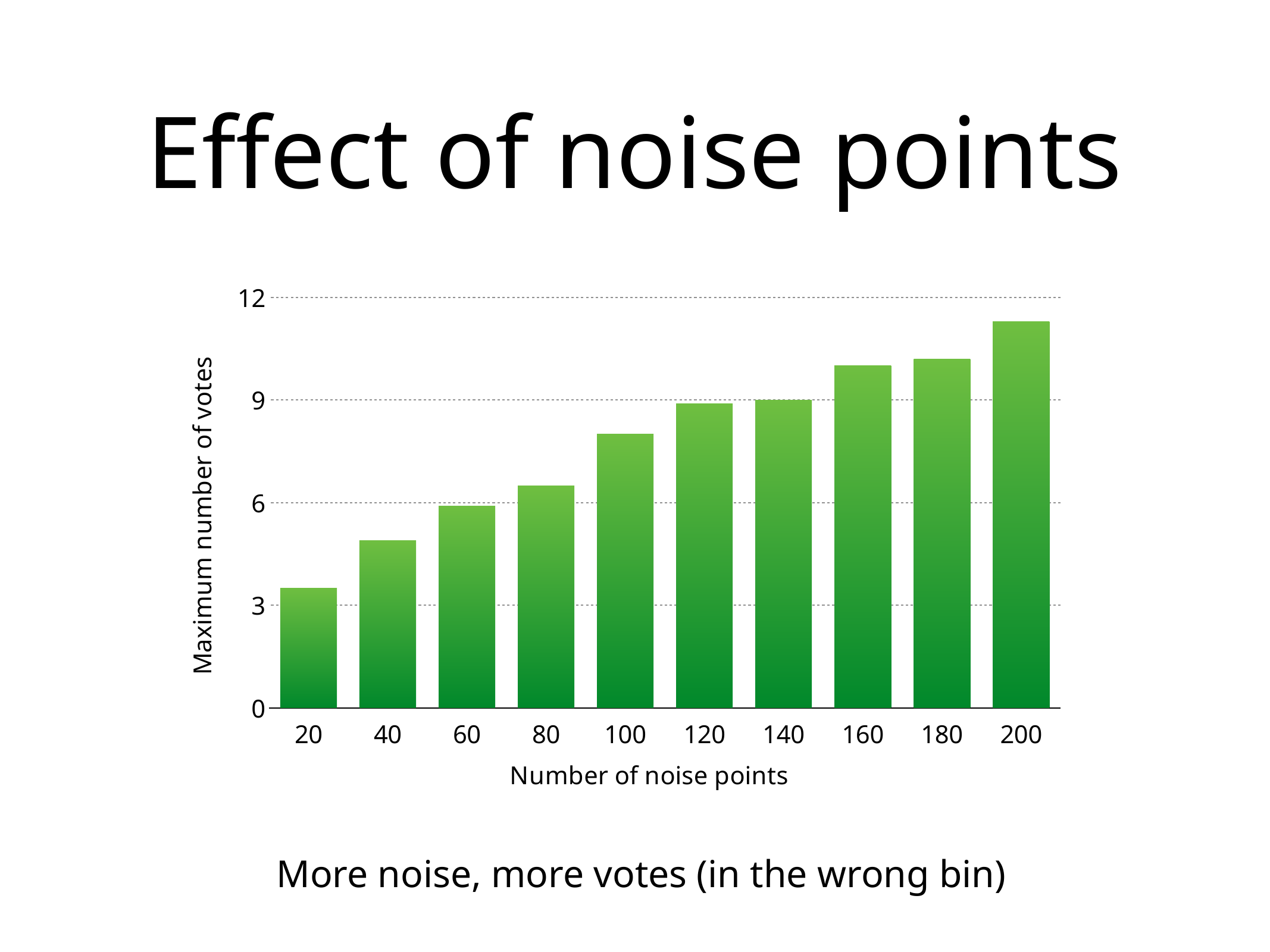
Is the value for 80 noise points greater or less than 6? greater Which number of noise points has the lowest maximum number of votes? 20 What is the label of the y axis? Maximum number of votes Do the values rise or fall as the number of noise points increases along the x axis? rise Which number of noise points has the highest maximum number of votes? 200 How many bars (categories) are plotted on the chart? 10 Is the value for 100 noise points greater or less than 9? less Which has a larger maximum number of votes: 200 noise points or 20 noise points? 200 Is the value for 200 noise points greater or less than 12? less What kind of chart is shown on the slide? bar chart